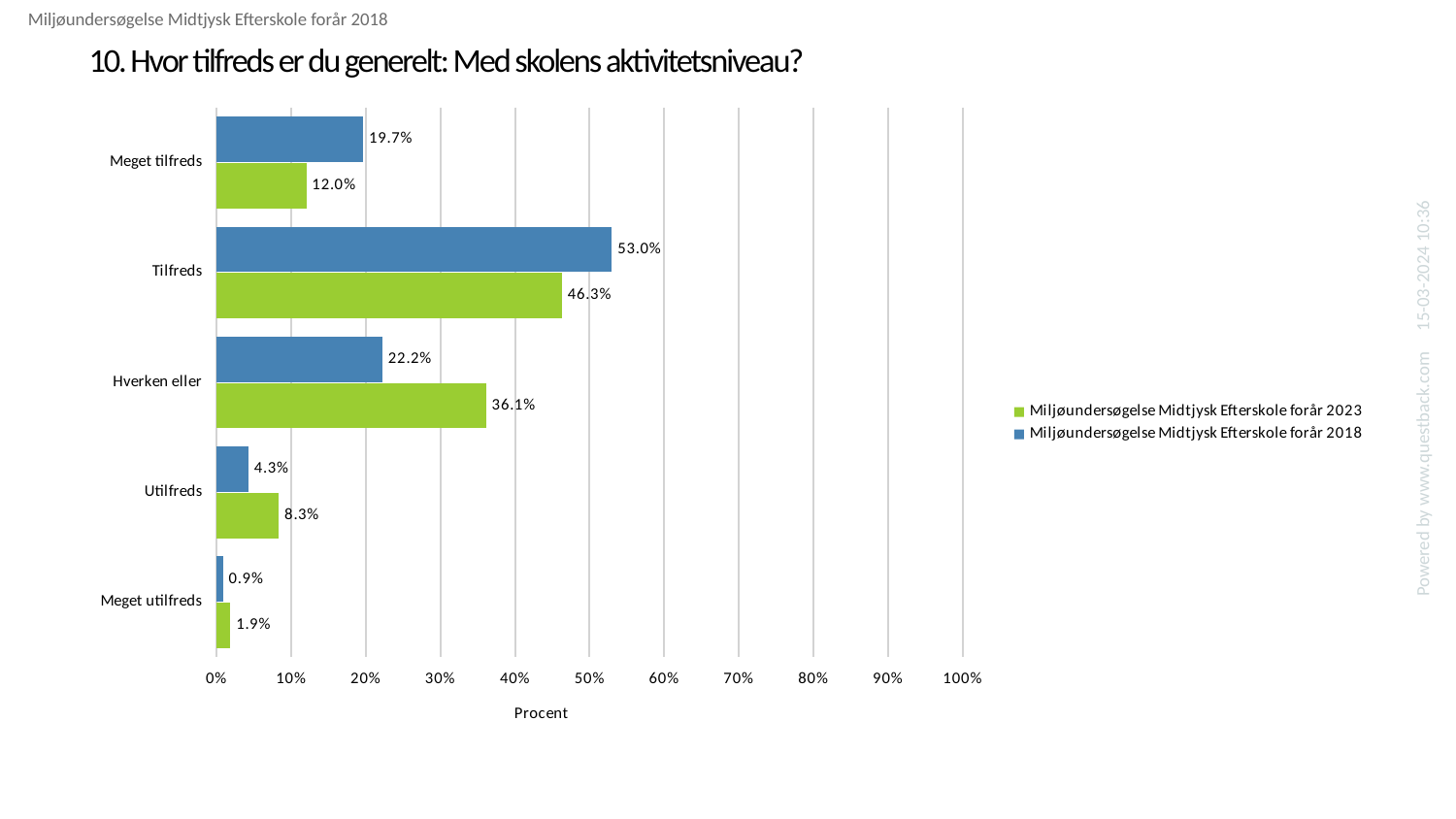
What is the difference between the 2018 and 2023 values for "Hverken eller"? 13.9% What kind of chart is shown on the slide? Bar chart What is the value for "Tilfreds" in the Miljøundersøgelse Midtjysk Efterskole forår 2018 series? 53.0% For "Meget tilfreds", which series has the larger value: 2018 or 2023? 2018 Which category has the lowest value in the Miljøundersøgelse Midtjysk Efterskole forår 2018 series? Meget utilfreds How many series does the legend list? 2 Which category has the highest value in the Miljøundersøgelse Midtjysk Efterskole forår 2023 series? Tilfreds How many categories are shown on the chart? 5 What is the value for "Hverken eller" in the Miljøundersøgelse Midtjysk Efterskole forår 2023 series? 36.1% Is the 2023 value for "Tilfreds" greater or less than 40%? greater What is the value for "Meget utilfreds" in the Miljøundersøgelse Midtjysk Efterskole forår 2018 series? 0.9% What is the label of the horizontal axis? Procent